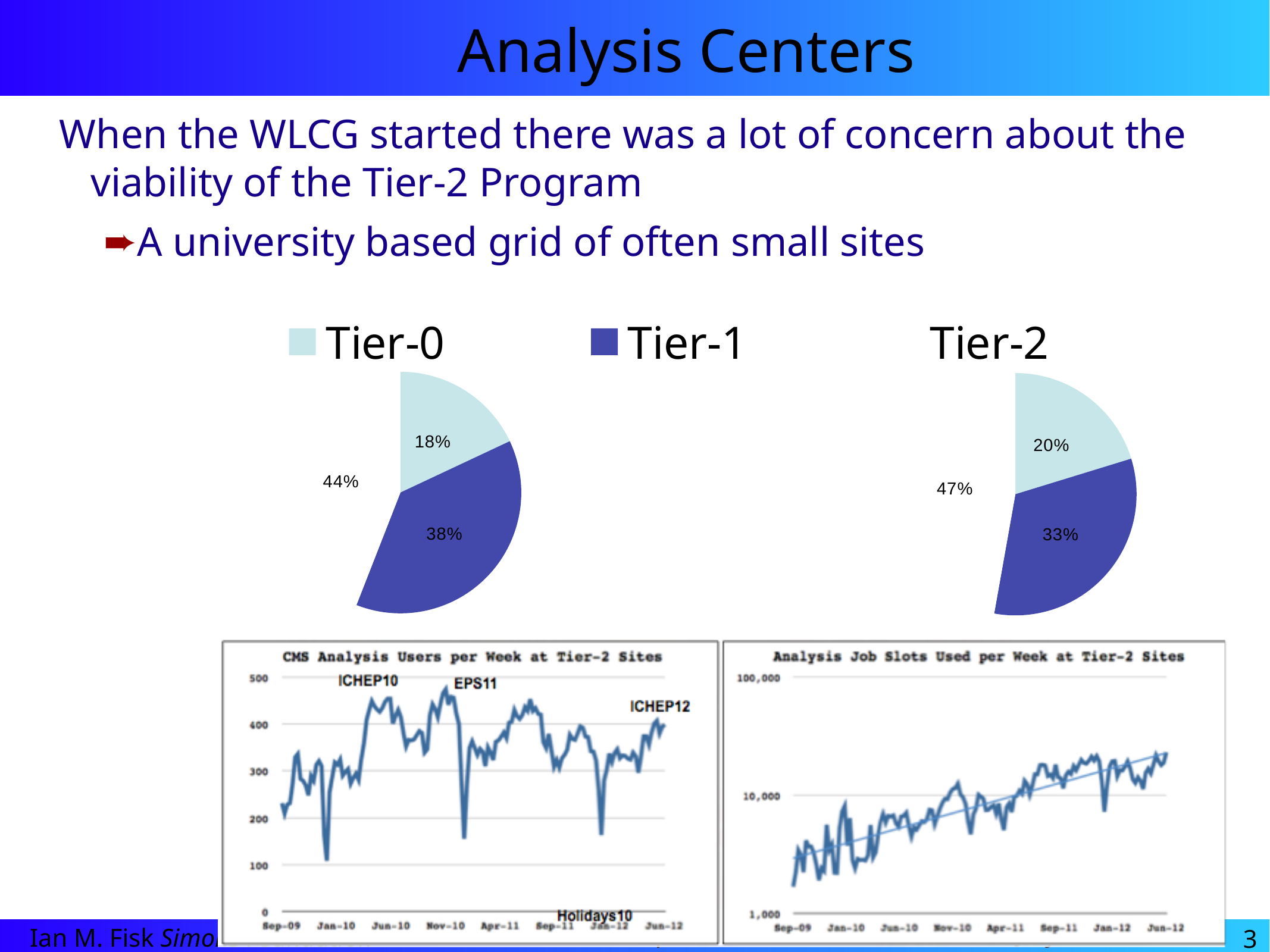
How many entries does the legend above the pie charts list? 3 In the left pie chart, what share is labelled for Tier-0? 18% In the right pie chart, what is the difference between the Tier-1 share and the Tier-0 share? 13% In the left pie chart, which is larger, the Tier-0 slice or the Tier-1 slice? Tier-1 What is the largest percentage label shown on the left pie chart? 44% What kind of chart is 'CMS Analysis Users per Week at Tier-2 Sites'? Line chart In the left pie chart, what share is labelled for Tier-1? 38% In the chart 'Analysis Job Slots Used per Week at Tier-2 Sites', do the values generally rise or fall from Sep-09 to Jun-12? Rise In the right pie chart, what share is labelled for Tier-0? 20% What kind of chart are the two charts in the middle of the slide? Pie chart In the chart 'Analysis Job Slots Used per Week at Tier-2 Sites', is the value at Jun-12 greater or less than 10,000? greater